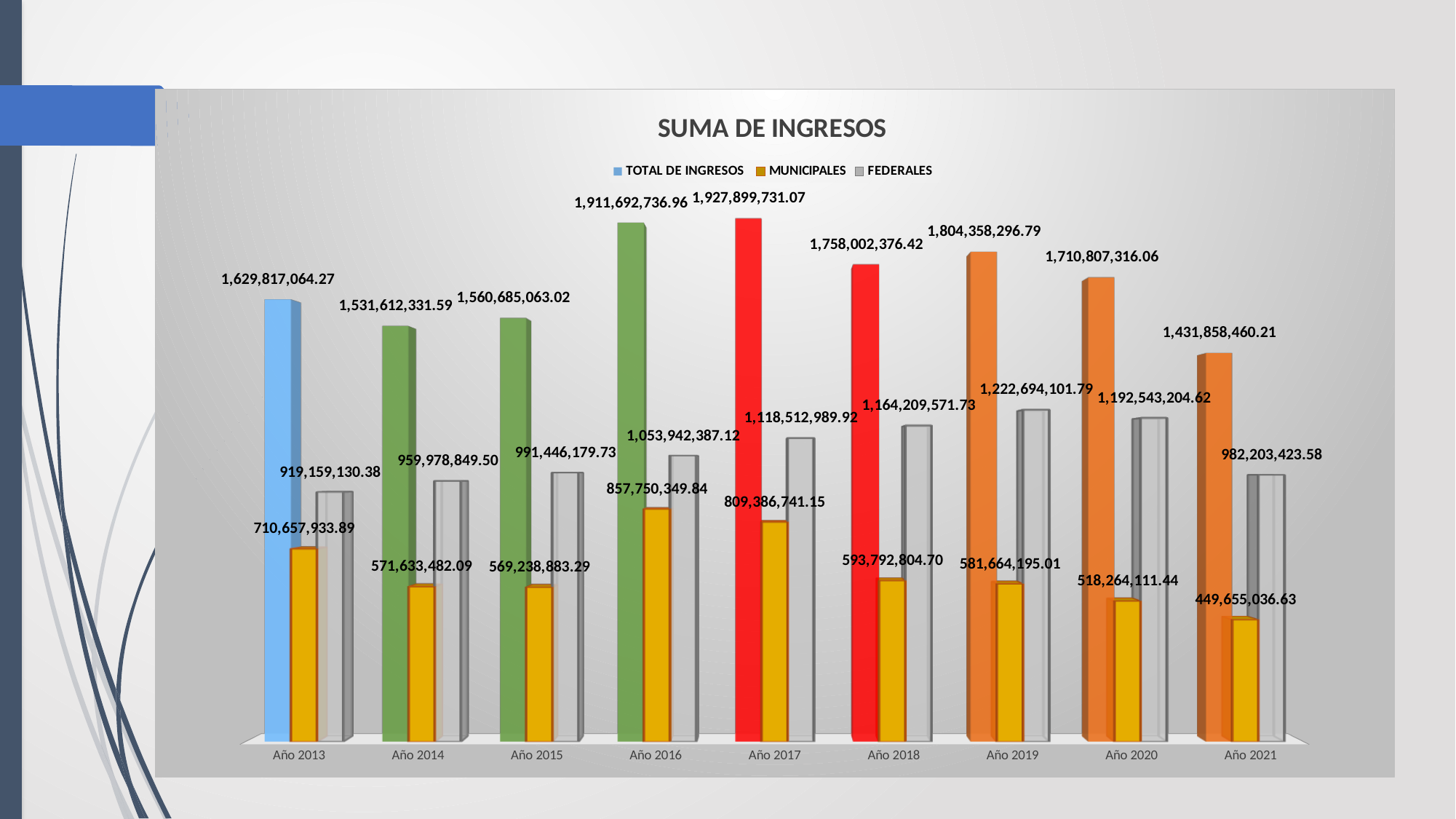
What is the FEDERALES value for Año 2019? 1,222,694,101.79 Which is larger for Año 2018: MUNICIPALES or FEDERALES? FEDERALES Which year has the lowest TOTAL DE INGRESOS? Año 2021 What is the difference between the FEDERALES and MUNICIPALES values for Año 2013? 208,501,196.49 What is the MUNICIPALES value for Año 2016? 857,750,349.84 Which year has the highest FEDERALES value? Año 2019 How many years are shown on the x axis? 9 Which year has the highest MUNICIPALES value? Año 2016 What is the title of the chart? SUMA DE INGRESOS What is the value of TOTAL DE INGRESOS for Año 2017? 1,927,899,731.07 What is the MUNICIPALES value for Año 2021? 449,655,036.63 How many series does the legend list? 3